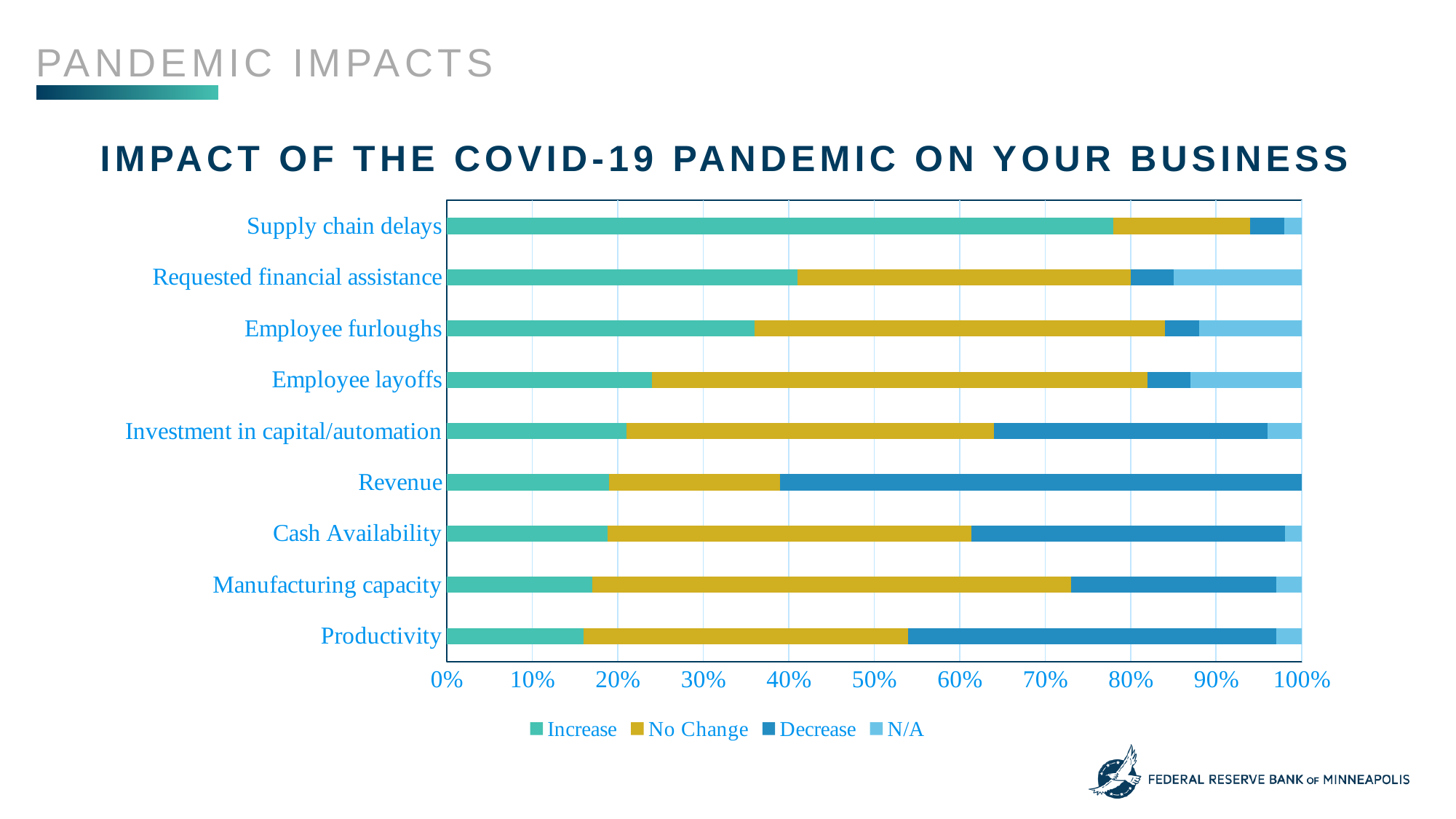
How many business impact categories are plotted on the chart? 9 Which category has the largest Increase share? Supply chain delays Which has the larger Increase share: Requested financial assistance or Employee layoffs? Requested financial assistance How many series does the legend list? 4 Is the Increase share for Productivity greater or less than 20%? less Which has the larger Decrease share: Revenue or Manufacturing capacity? Revenue What kind of chart is shown on the slide? Stacked bar chart Is the Increase share for Supply chain delays greater or less than 70%? greater What are the four legend entries of the chart? Increase, No Change, Decrease, N/A Which category has the largest Decrease share? Revenue What is the title of the chart? Impact of the COVID-19 Pandemic on Your Business Is the Increase share for Requested financial assistance greater or less than 30%? greater